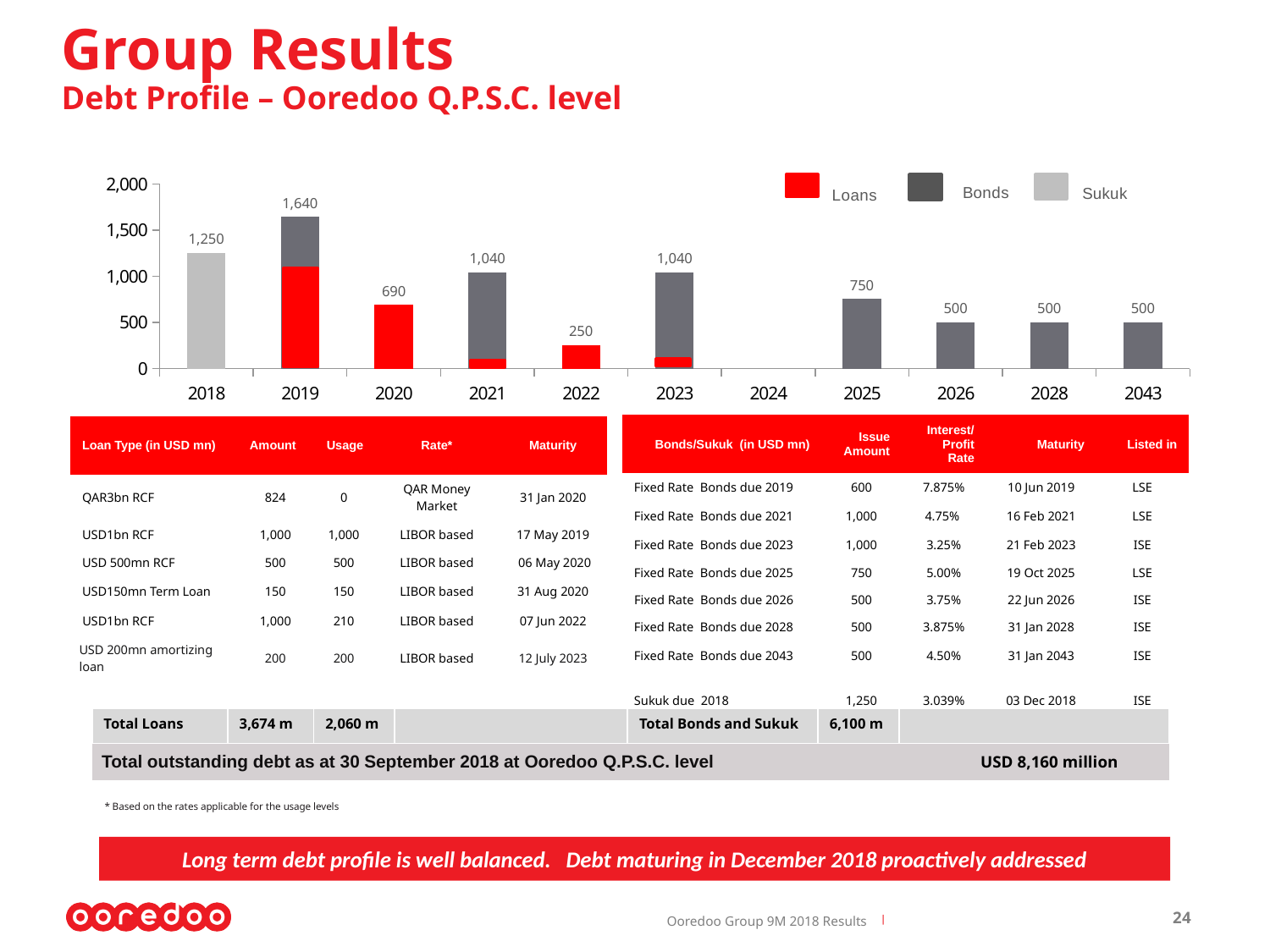
How many series does the chart legend list? 3 What kind of chart is shown on the slide? Stacked bar chart What is the difference between the 2019 total and the 2018 total in the chart? 390 How many years are shown on the x axis of the chart? 11 What is the value labelled for 2025 in the chart? 750 Which series in the chart is shown in light grey? Sukuk What is the total debt value shown for 2019 in the chart? 1,640 Which colour represents Loans in the chart legend? Red Which is larger in the chart, the total for 2020 or the total for 2022? 2020 What is the value labelled for 2018 in the chart? 1,250 Is the Loans portion of the 2021 bar greater or less than 500? less Which year has the highest total in the chart? 2019